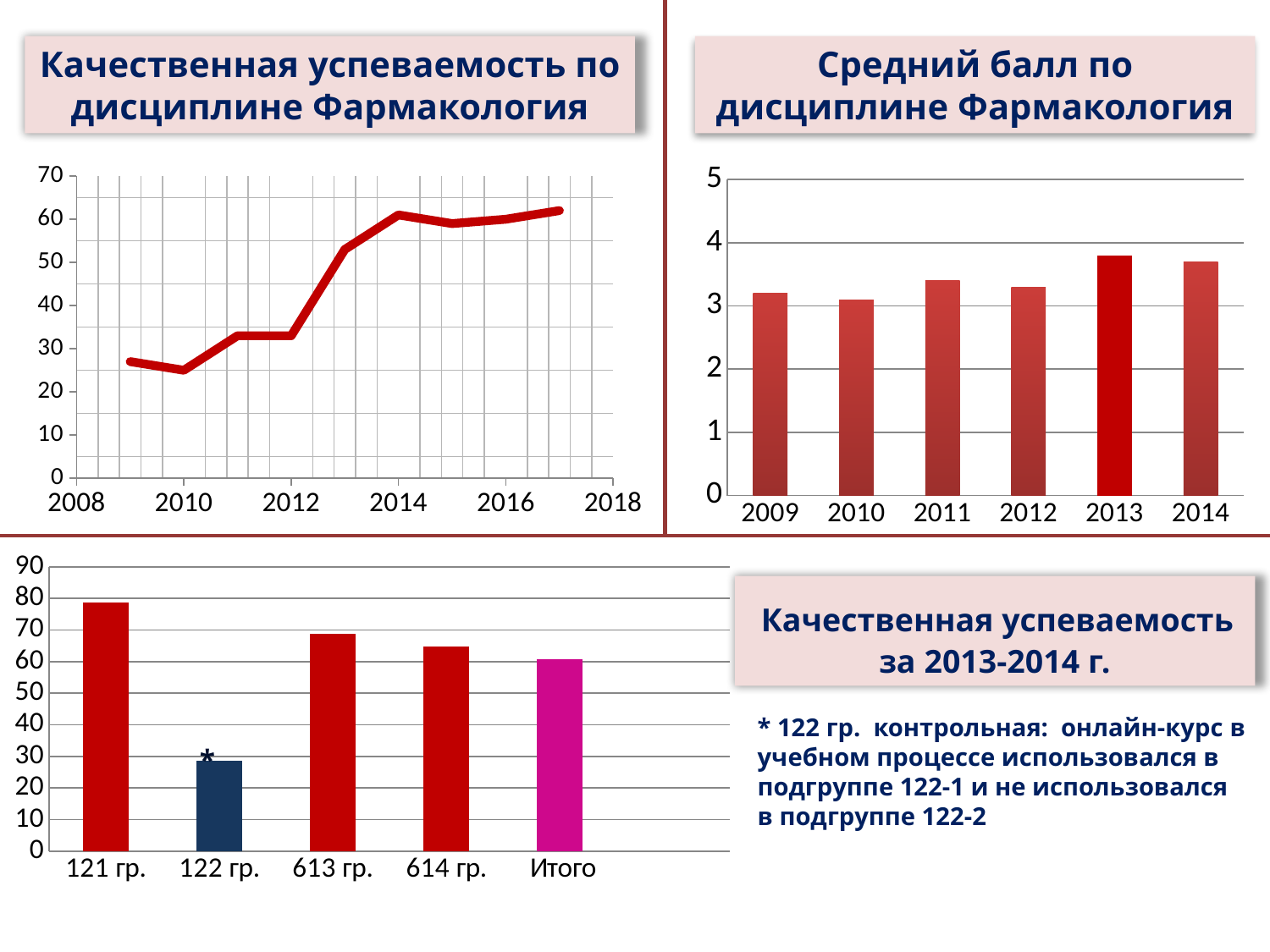
In the top-left chart "Качественная успеваемость по дисциплине Фармакология", do the values generally rise or fall from 2009 to 2017? rise In the top-right chart "Средний балл по дисциплине Фармакология", is the value for 2013 greater or less than 4? less In the bottom chart "Качественная успеваемость за 2013-2014 г.", which group has the highest value? 121 гр. In the top-left chart "Качественная успеваемость по дисциплине Фармакология", is the value for 2013 greater or less than 50? greater What kind of chart is the top-right chart titled "Средний балл по дисциплине Фармакология"? bar chart In the bottom chart "Качественная успеваемость за 2013-2014 г.", is the value for 122 гр. greater or less than 30? less In the top-right chart "Средний балл по дисциплине Фармакология", how many years are shown? 6 What kind of chart is the top-left chart titled "Качественная успеваемость по дисциплине Фармакология"? line chart In the top-right chart "Средний балл по дисциплине Фармакология", which is larger, the value for 2013 or the value for 2010? 2013 In the top-left chart "Качественная успеваемость по дисциплине Фармакология", how many data points are plotted on the line? 9 In the bottom chart "Качественная успеваемость за 2013-2014 г.", which group has the lowest value? 122 гр.